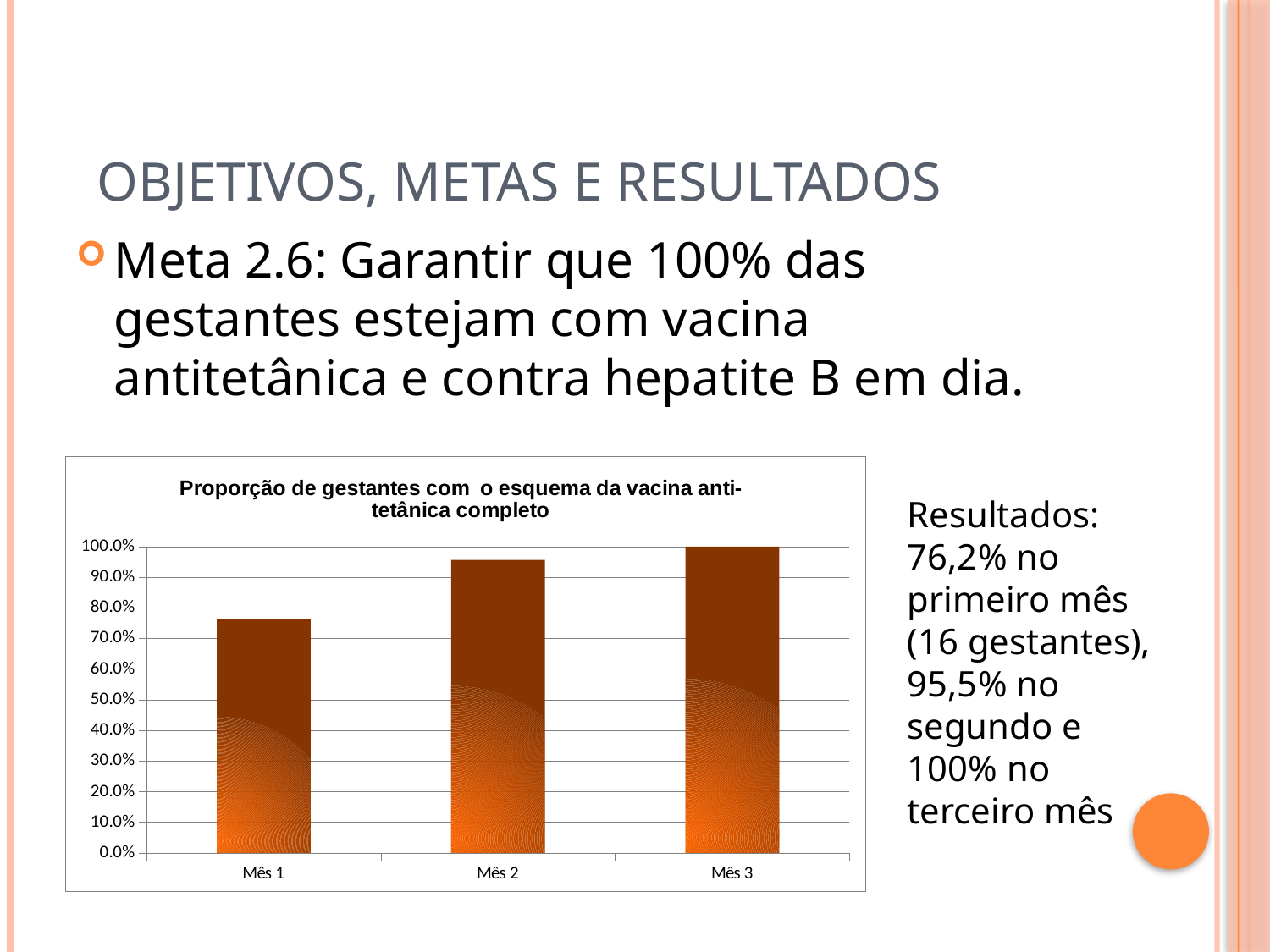
Is the value for Mês 1 greater or less than 80.0%? less According to the slide, what was the proportion in the second month (Mês 2)? 95,5% What is the title of the chart? Proporção de gestantes com o esquema da vacina anti-tetânica completo Do the values rise or fall from Mês 1 to Mês 3? rise Is the value for Mês 2 greater or less than 90.0%? greater Which month has the highest proportion of pregnant women with the complete anti-tetanus vaccine scheme? Mês 3 How many categories (months) are plotted in the chart? 3 According to the slide, what was the proportion in the first month (Mês 1)? 76,2% What is the proportion for Mês 3? 100.0% What kind of chart is shown on the slide? bar chart Which is larger, the value for Mês 1 or the value for Mês 2? Mês 2 Which month has the lowest proportion in the chart? Mês 1